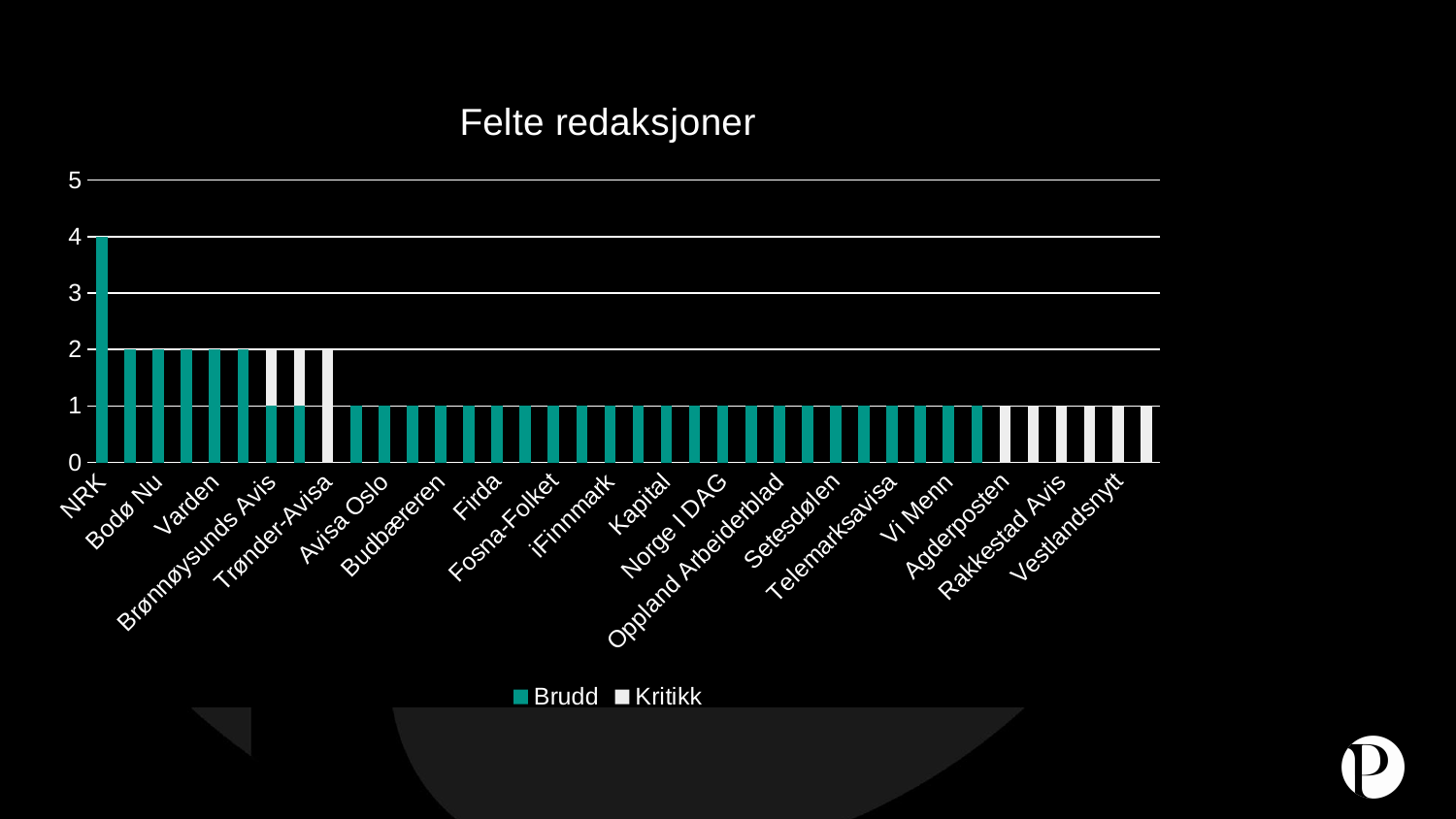
What is the title of the chart? Felte redaksjoner Is the value for NRK greater or less than 3? greater What is the value for Vestlandsnytt? 1 What is the difference between the value for NRK and the value for Vestlandsnytt? 3 Which series does the bar for NRK belong to? Brudd Which category has the highest value? NRK What are the two series named in the legend? Brudd and Kritikk What kind of chart is shown on the slide? Bar chart How many series does the legend list? 2 What is the value for NRK? 4 Do the values rise or fall moving from left to right along the x axis? Fall Which is larger, the value for NRK or the value for Bodø Nu? NRK